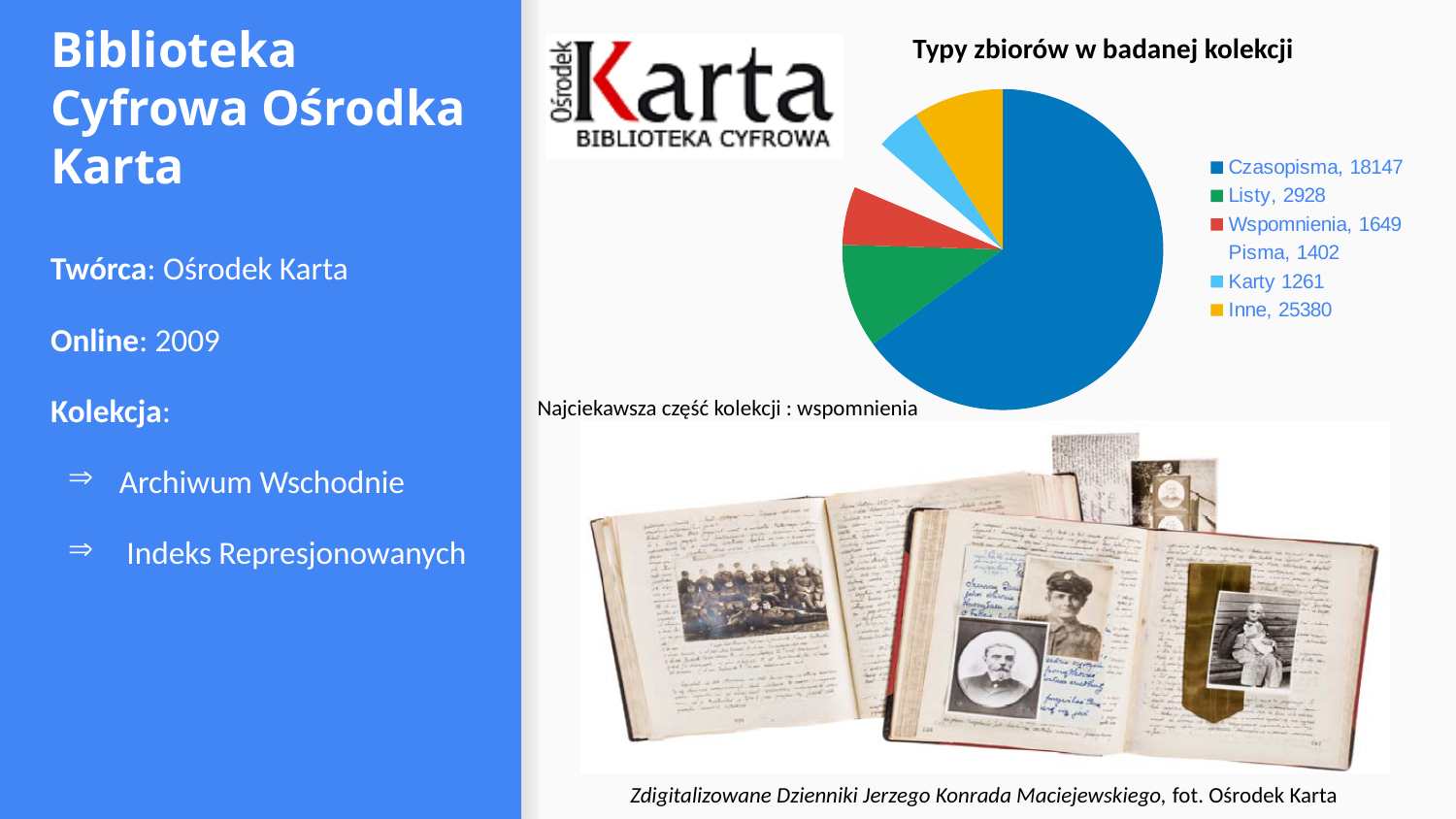
In the chart "Typy zbiorów w badanej kolekcji", what value is given for Listy? 2928 In the chart "Typy zbiorów w badanej kolekcji", what colour is the Czasopisma slice? blue In the chart "Typy zbiorów w badanej kolekcji", which has the larger value, Listy or Wspomnienia? Listy In the chart "Typy zbiorów w badanej kolekcji", what value is given for Inne? 25380 What type of chart is shown under the title "Typy zbiorów w badanej kolekcji"? pie chart In the chart "Typy zbiorów w badanej kolekcji", what value is given for Karty? 1261 In the chart "Typy zbiorów w badanej kolekcji", what value is given for Pisma? 1402 What is the title of the pie chart on the slide? Typy zbiorów w badanej kolekcji How many entries does the legend of the chart "Typy zbiorów w badanej kolekcji" list? 6 In the chart "Typy zbiorów w badanej kolekcji", what value is given for Czasopisma? 18147 In the chart "Typy zbiorów w badanej kolekcji", what is the difference between the values for Czasopisma and Listy? 15219 In the chart "Typy zbiorów w badanej kolekcji", what value is given for Wspomnienia? 1649